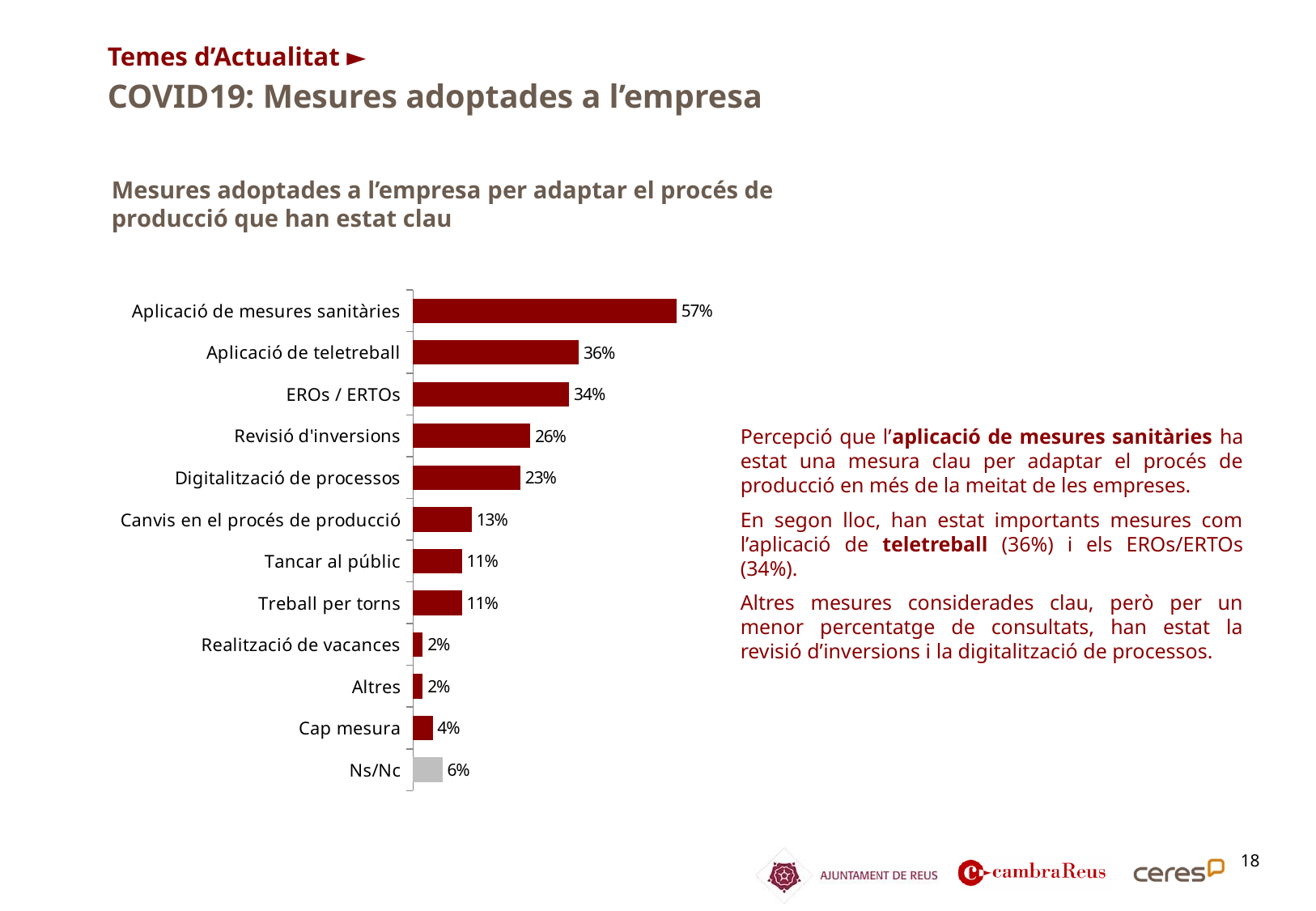
Which is larger, Cap mesura or Altres? Cap mesura How many categories are shown in the chart? 12 What kind of chart is shown on the slide? Bar chart What is the difference between Aplicació de mesures sanitàries and Revisió d'inversions? 31% What is the value for Cap mesura? 4% Which category's bar is shown in grey rather than dark red? Ns/Nc Which is larger, Canvis en el procés de producció or Ns/Nc? Canvis en el procés de producció What is the value for Digitalització de processos? 23% Which category has the highest value? Aplicació de mesures sanitàries What is the difference between Aplicació de teletreball and EROs / ERTOs? 2% What is the value for Tancar al públic? 11% What is the value for Aplicació de mesures sanitàries? 57%